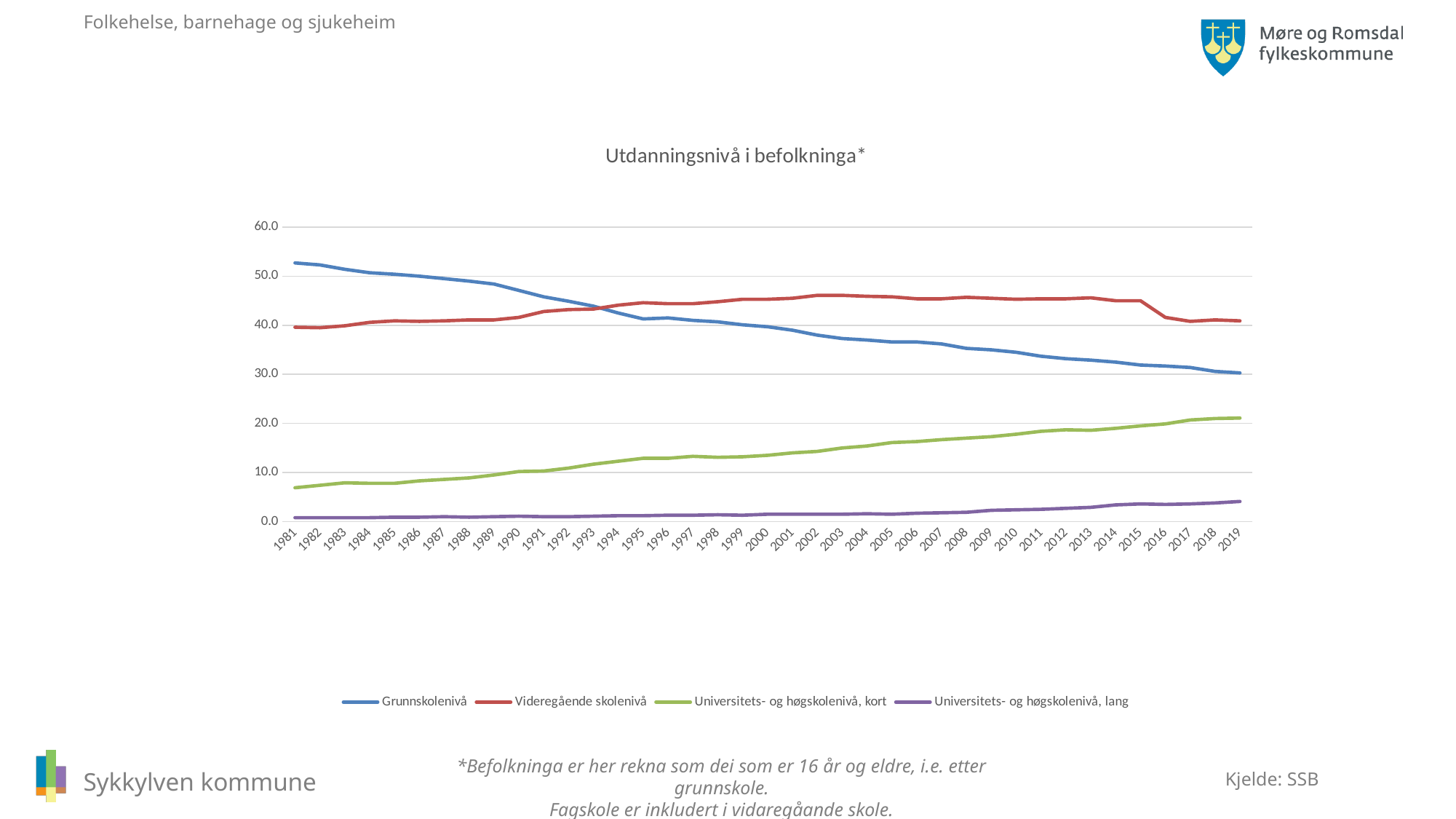
Which series has the highest value in 2019? Videregående skolenivå In 2019, which is larger: Videregående skolenivå or Grunnskolenivå? Videregående skolenivå Does the Universitets- og høgskolenivå, kort line rise or fall from 1981 to 2019? rise Is the value for Universitets- og høgskolenivå, kort in 1981 greater or less than 10.0? less Which series has the highest value in 1981? Grunnskolenivå What kind of chart is shown on the slide? line chart Does the Grunnskolenivå line rise or fall from 1981 to 2019? fall How many years are plotted along the x axis? 39 What is the title of the chart? Utdanningsnivå i befolkninga* Is the value for Grunnskolenivå in 1981 greater or less than 50.0? greater Which series has the lowest value in 2019? Universitets- og høgskolenivå, lang How many series does the legend list? 4